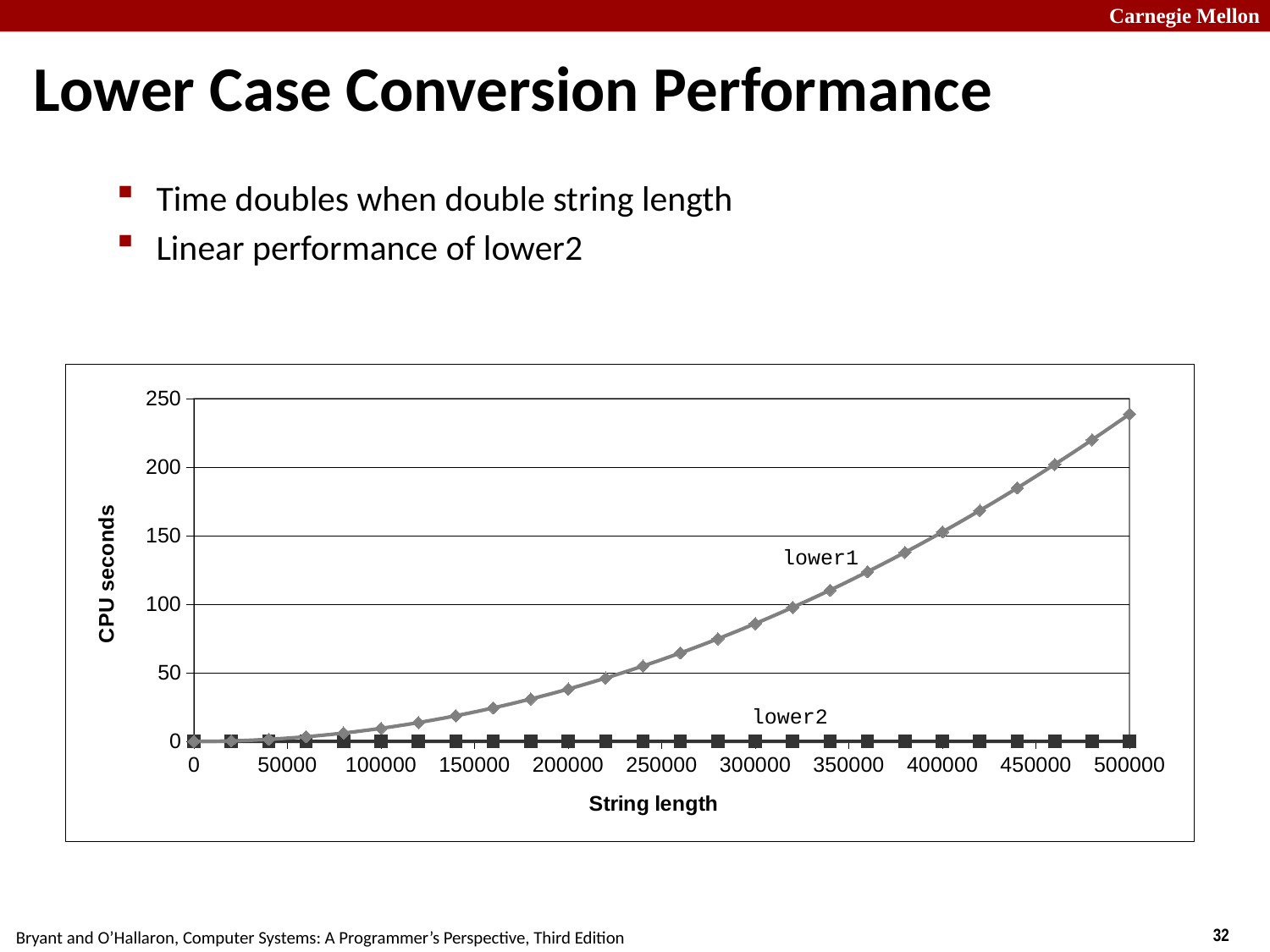
Is the value for lower2 at string length 500000 greater or less than 50? less Which series reaches the highest CPU seconds value on the chart? lower1 Do the values for lower1 rise or fall as string length increases? rise What kind of chart is shown on the slide? line chart How many series are plotted on the chart? 2 Is the value for lower1 at string length 300000 greater or less than 100? less Is the value for lower1 at string length 200000 greater or less than 50? less What is the label of the y axis? CPU seconds At string length 500000, which series has the larger CPU seconds value, lower1 or lower2? lower1 What is the label of the x axis? String length